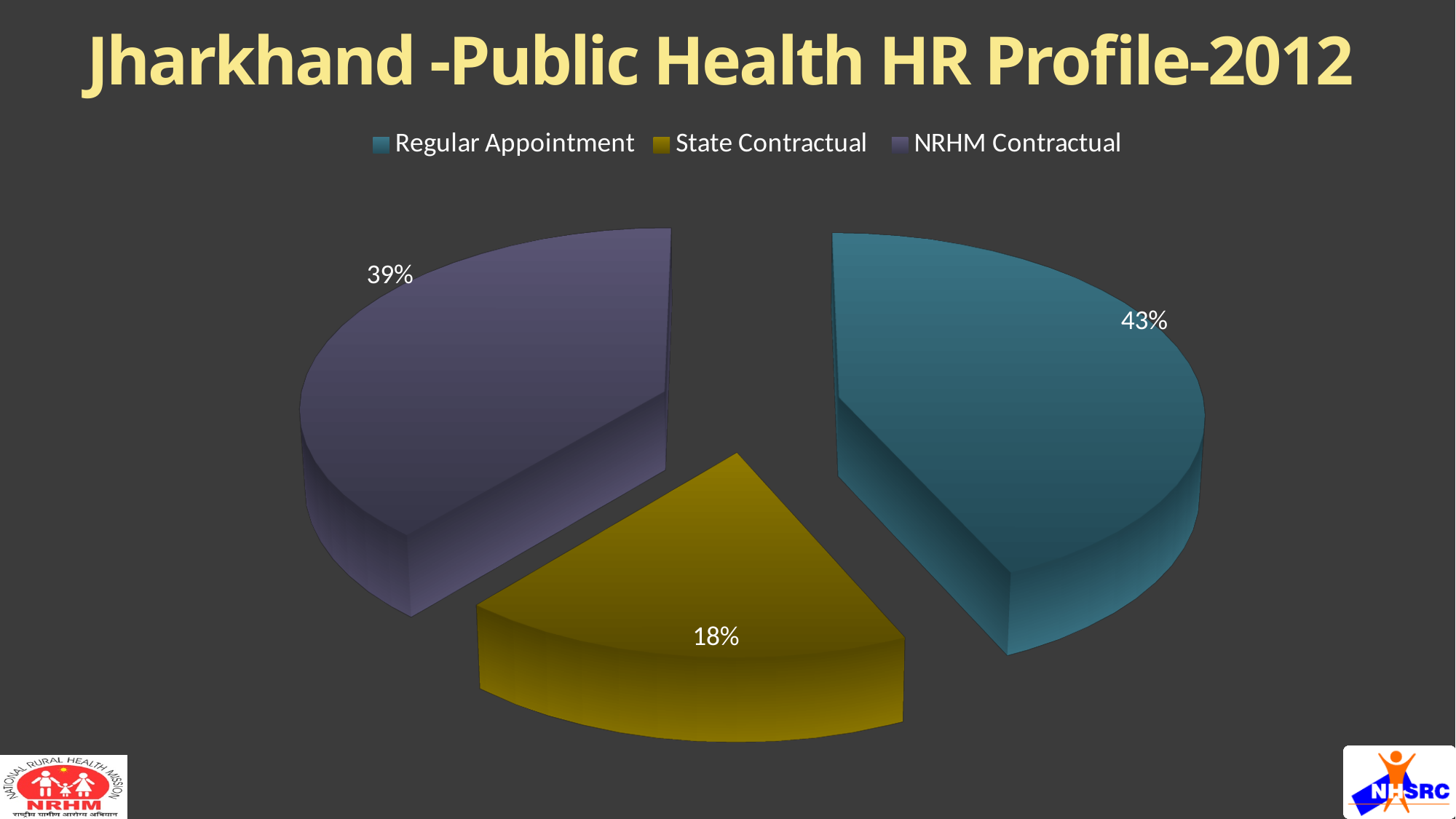
What kind of chart is shown on the slide? Pie chart Which is larger, the share for State Contractual or the share for NRHM Contractual? NRHM Contractual Which category has the largest slice of the pie? Regular Appointment What share of the pie does Regular Appointment represent? 43% How many slices does the pie chart have? 3 What is the title of the slide? Jharkhand -Public Health HR Profile-2012 Which category has the smallest slice of the pie? State Contractual What share of the pie does State Contractual represent? 18% What is the difference in percentage points between Regular Appointment and NRHM Contractual? 4% How many entries does the legend list? 3 What is the difference in percentage points between NRHM Contractual and State Contractual? 21% What share of the pie does NRHM Contractual represent? 39%